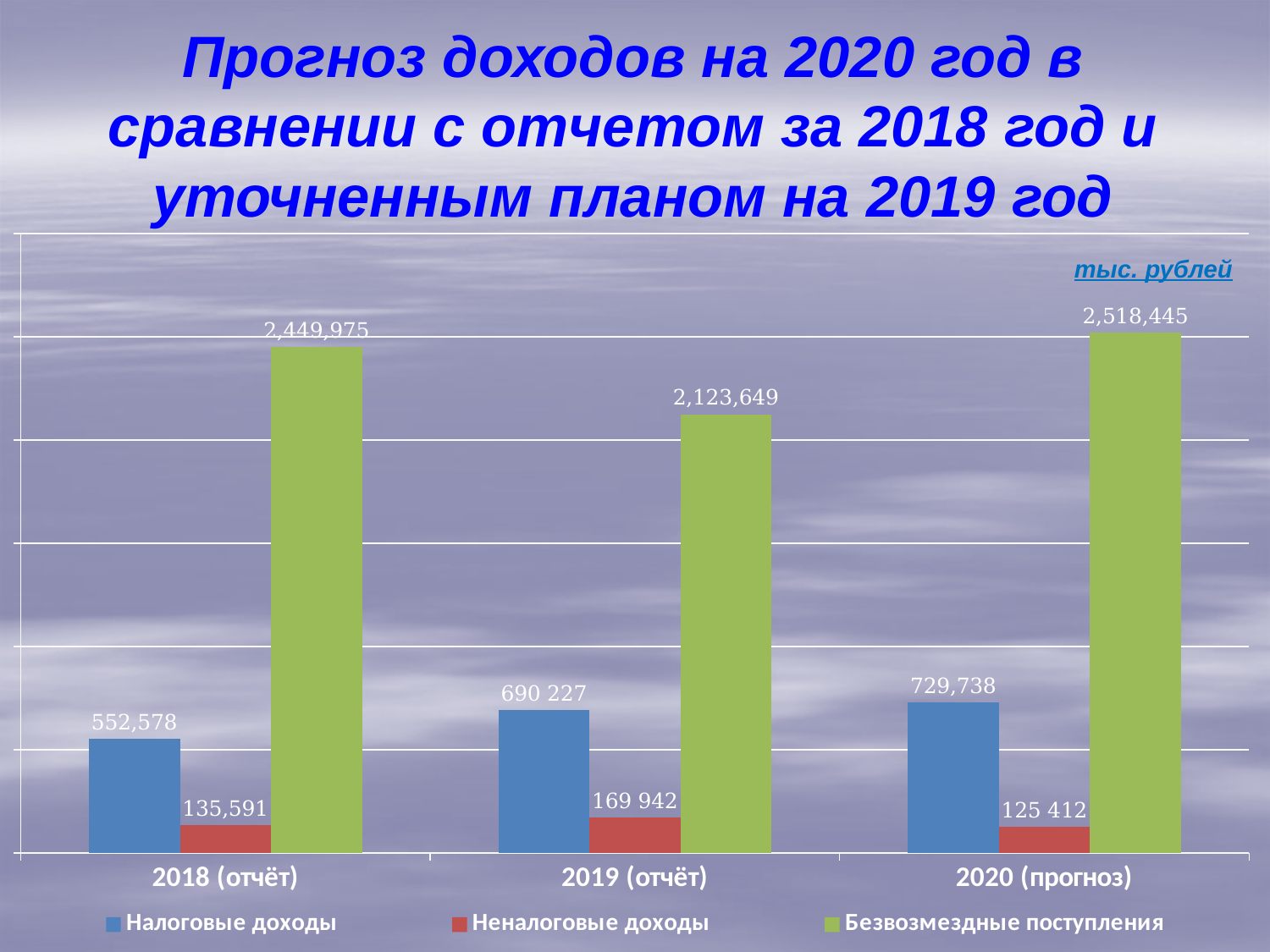
Do the values of Налоговые доходы rise or fall from 2018 to 2020? Rise Which is larger: Налоговые доходы in 2019 (отчёт) or in 2020 (прогноз)? 2020 (прогноз) What is the value of Неналоговые доходы for 2019 (отчёт)? 169 942 What kind of chart is shown on the slide? Bar chart In which year is Безвозмездные поступления the highest? 2020 (прогноз) How many year categories are shown on the x axis? 3 How many series does the legend list? 3 What is the value of Безвозмездные поступления for 2020 (прогноз)? 2,518,445 In which year is Неналоговые доходы the lowest? 2020 (прогноз) What is the value of Налоговые доходы for 2018 (отчёт)? 552,578 What is the difference between Безвозмездные поступления in 2020 (прогноз) and in 2019 (отчёт)? 394,796 What is the difference between Налоговые доходы in 2020 (прогноз) and in 2018 (отчёт)? 177,160